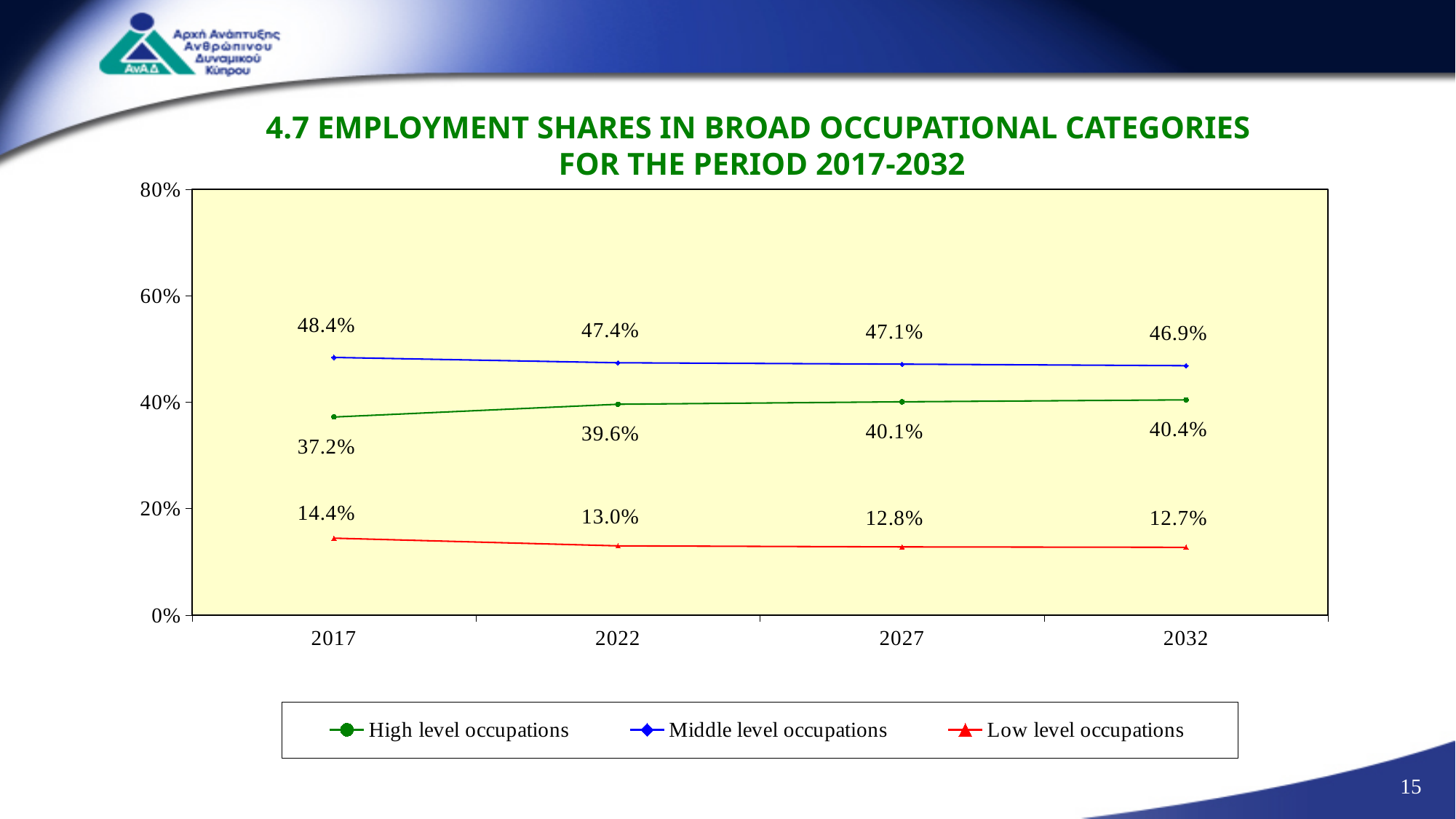
Does the share of High level occupations rise or fall from 2017 to 2032? Rise How many years are shown on the x axis? 4 What is the employment share of High level occupations in 2032? 40.4% How many series does the legend list? 3 Is the value for Middle level occupations in 2022 greater or less than 40%? greater In which year is the share of Low level occupations lowest? 2032 Which is larger in 2027: the share of High level occupations or Low level occupations? High level occupations What kind of chart is shown on the slide? Line chart In which year is the share of High level occupations highest? 2032 What is the employment share of Middle level occupations in 2017? 48.4% What is the employment share of Low level occupations in 2022? 13.0% What is the difference between the Middle level occupations share in 2017 and in 2032? 1.5%